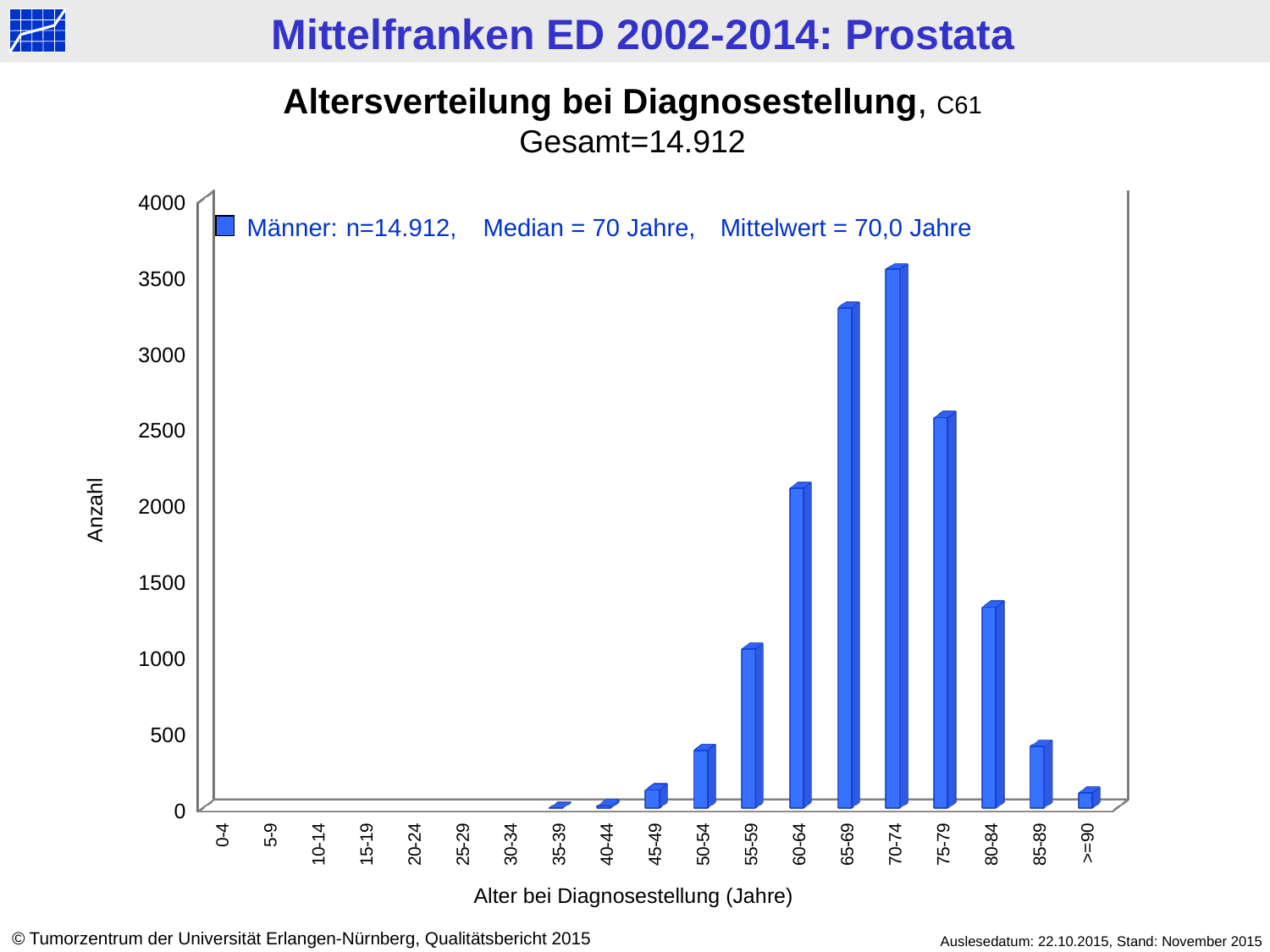
Which age group has a larger value, 65-69 or 75-79? 65-69 Is the value for the 50-54 age group greater or less than 500? less How many age categories are shown on the x axis? 19 How many series does the legend list? 1 Is the value for the 80-84 age group greater or less than 1500? less Which age group has the highest number of diagnoses? 70-74 Do the values rise or fall along the x axis from the 70-74 group to the >=90 group? fall What is the median age at diagnosis stated in the legend? 70 Jahre Is the value for the 65-69 age group greater or less than 3000? greater What total number of cases (Gesamt) is stated above the chart? 14.912 What kind of chart is shown on the slide? bar chart